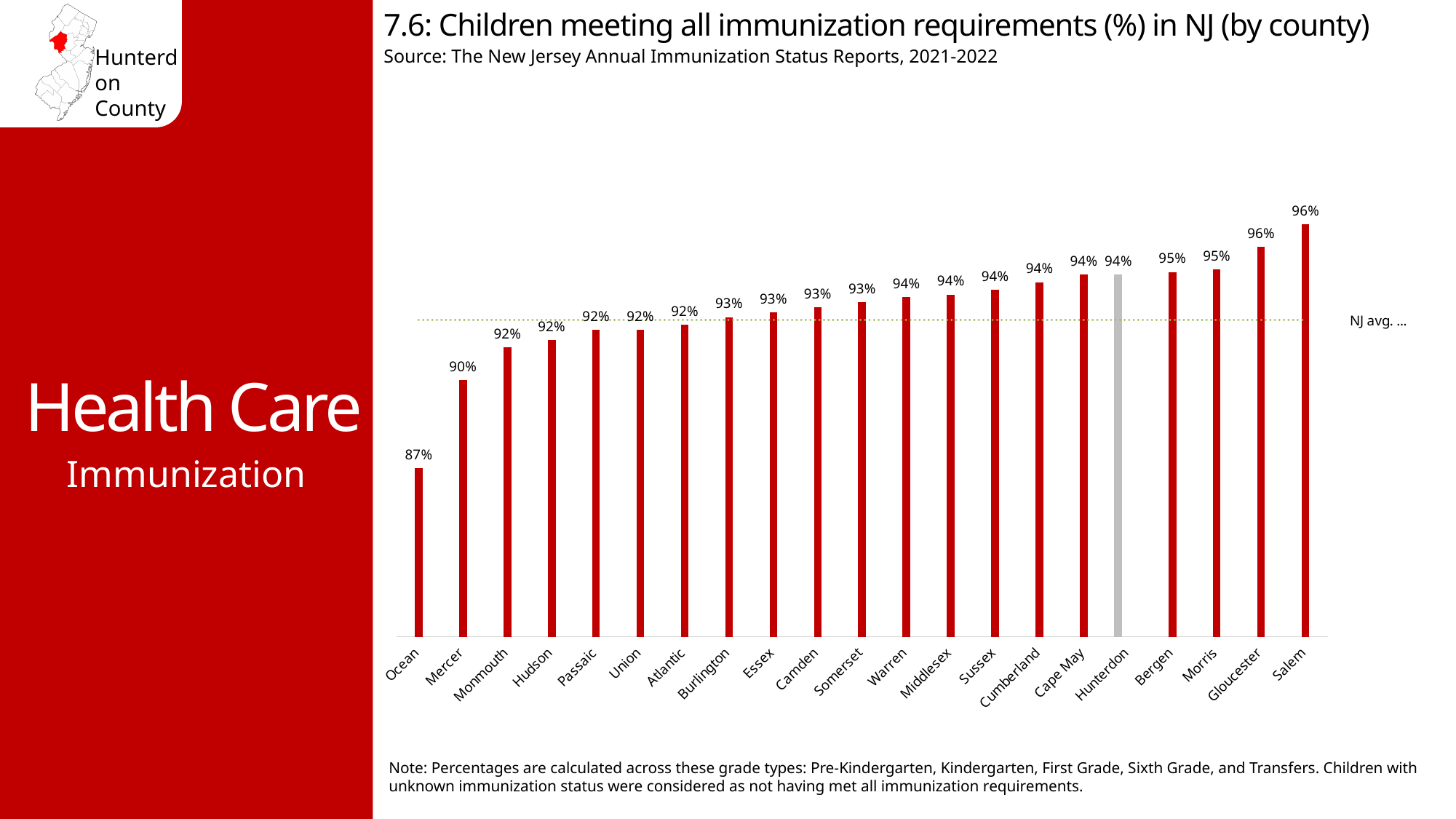
What is the value shown for Mercer County? 90% Do the values generally rise or fall moving from left to right across the counties? Rise Which has a higher value, Hunterdon or Mercer? Hunterdon What percentage of children in Hunterdon County met all immunization requirements? 94% Which county has the lowest percentage of children meeting all immunization requirements? Ocean What is the difference in percentage points between Hunterdon and Ocean? 7 percentage points What is the value shown for Bergen County? 95% Which county's bar is colored gray instead of red? Hunterdon How many counties are shown in the chart? 21 What type of chart is shown on the slide? Bar chart What is the value shown for Ocean County? 87% What is the difference in percentage points between Salem (96%) and Ocean (87%)? 9 percentage points